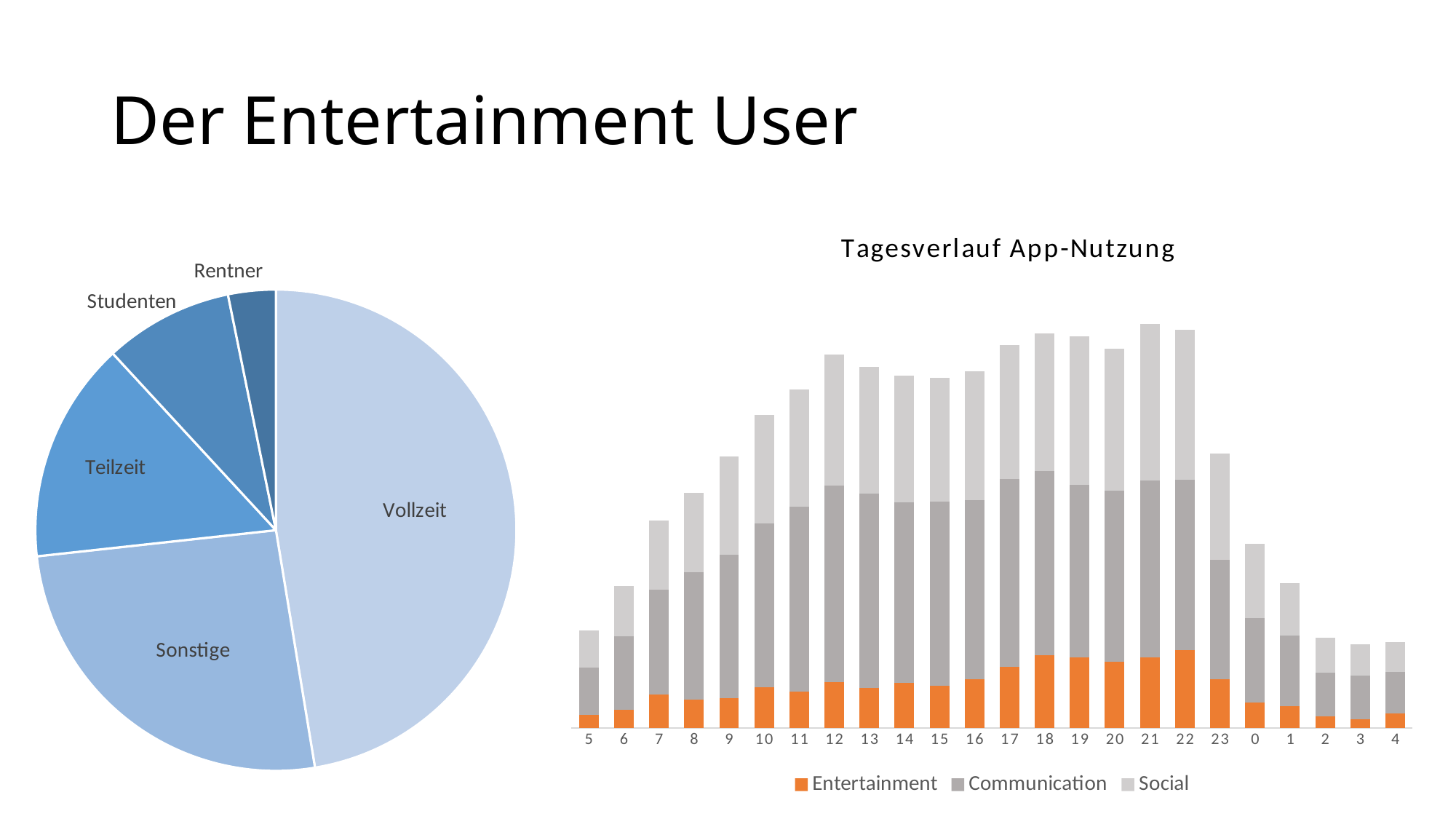
How many hour categories are shown on the x axis of 'Tagesverlauf App-Nutzung'? 24 In the pie chart on the left, which category has the largest slice? Vollzeit What kind of chart is the chart on the left of the slide? pie chart In 'Tagesverlauf App-Nutzung', which colour represents the Entertainment series? orange How many series does the legend of 'Tagesverlauf App-Nutzung' list? 3 In 'Tagesverlauf App-Nutzung', at which hour is the total stacked bar the shortest? 3 In the pie chart on the left, which category has the smallest slice? Rentner How many slices does the pie chart on the left have? 5 In 'Tagesverlauf App-Nutzung', at which hour is the total stacked bar the tallest? 21 What kind of chart is 'Tagesverlauf App-Nutzung'? stacked bar chart In 'Tagesverlauf App-Nutzung', do the total bars rise or fall from hour 5 to hour 12? rise In the pie chart on the left, which slice is larger, Teilzeit or Studenten? Teilzeit